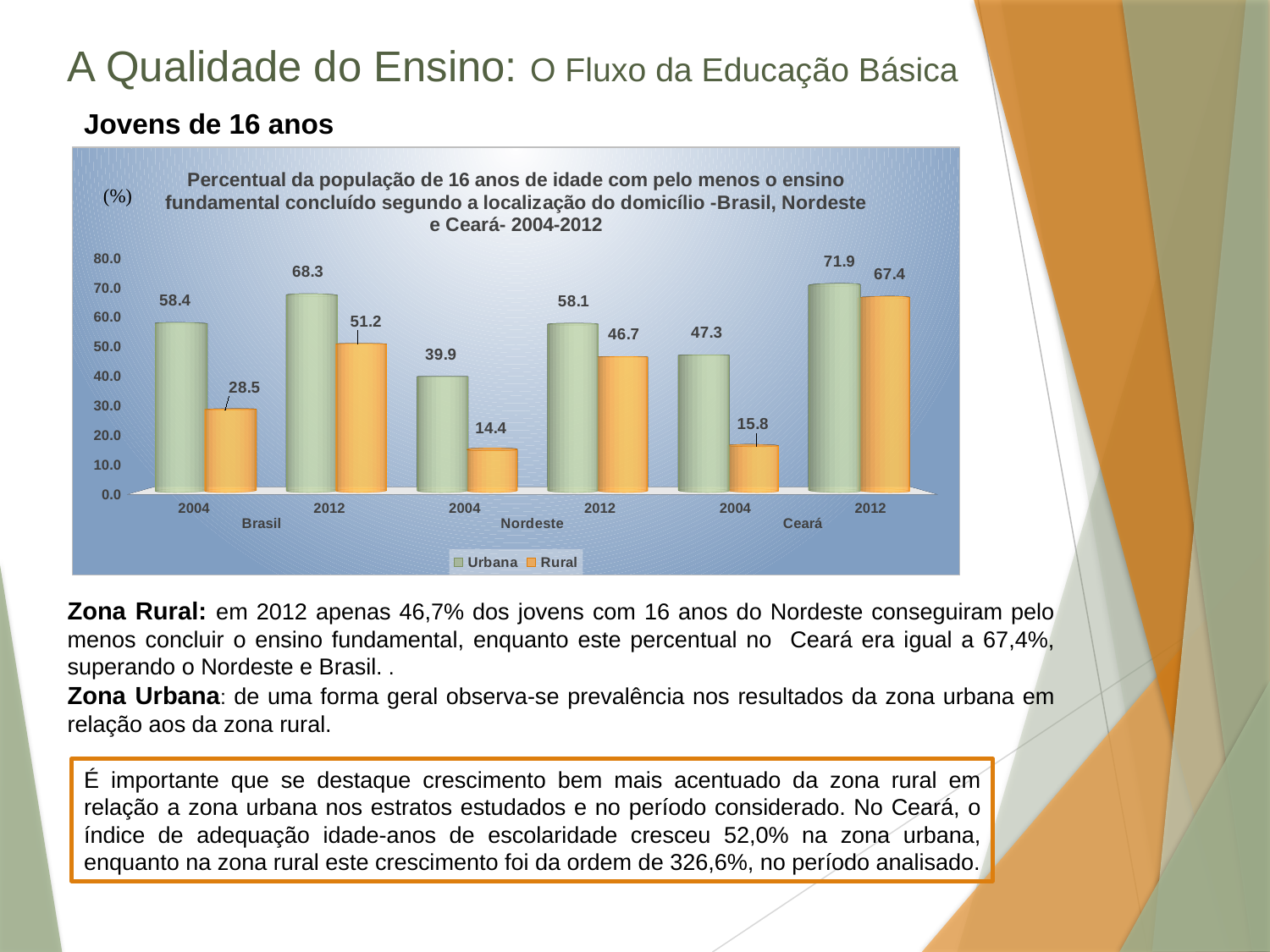
Which category has the highest Urbana value? Ceará 2012 Which colour represents the Rural series in the chart? Orange What is the Rural value for Nordeste in 2012? 46.7 How many series does the legend list? 2 What kind of chart is shown on the slide? Bar chart Which category has the lowest Rural value? Nordeste 2004 What is the Urbana value for Brasil in 2004? 58.4 How many bars are plotted for the Rural series? 6 Which is larger: the Rural value for Ceará in 2012 or the Rural value for Brasil in 2012? Ceará 2012 What is the Rural value for Ceará in 2004? 15.8 What is the difference between the Urbana and Rural values for Brasil in 2012? 17.1 What is the Urbana value for Nordeste in 2004? 39.9